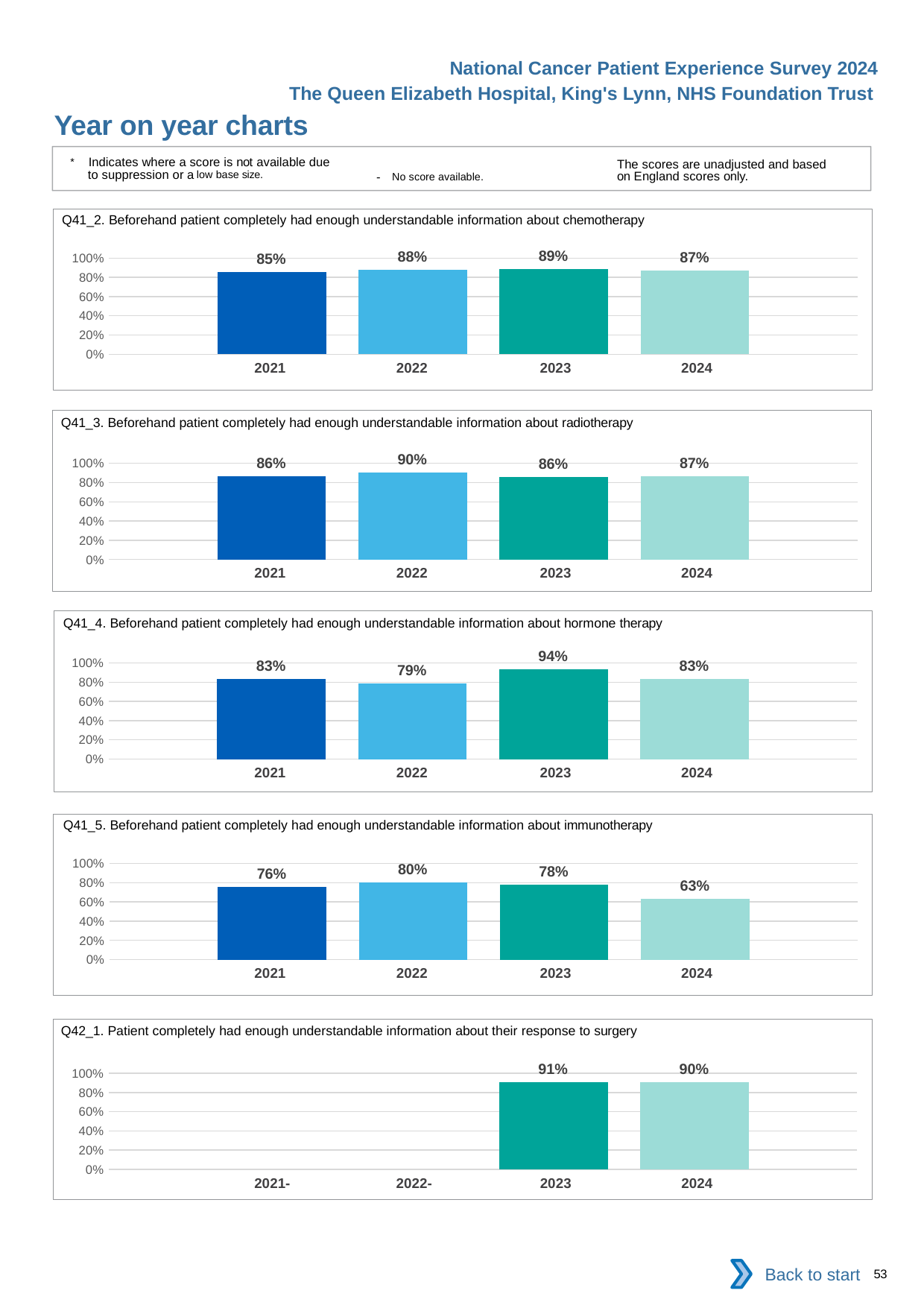
In the Q41_2 chart (chemotherapy), which year has the lowest value? 2021 In the Q41_4 chart (hormone therapy), what is the value for 2023? 94% In the Q41_5 chart (immunotherapy), what is the difference between the 2022 and 2024 values? 17 percentage points In the Q41_4 chart (hormone therapy), which year has the lowest value? 2022 In the Q41_3 chart (radiotherapy), which year has the highest value? 2022 In the Q42_1 chart (response to surgery), what is the value for 2023? 91% What type of chart is used in the Q41_2 chart (chemotherapy)? Bar chart In the Q41_2 chart (chemotherapy), what is the value for 2023? 89% In the Q41_5 chart (immunotherapy), is the value for 2021 larger or smaller than the value for 2023? smaller In the Q41_5 chart (immunotherapy), what is the value for 2024? 63% In the Q42_1 chart (response to surgery), how many years have a bar plotted? 2 In the Q41_3 chart (radiotherapy), what is the difference between the 2022 and 2024 values? 3 percentage points